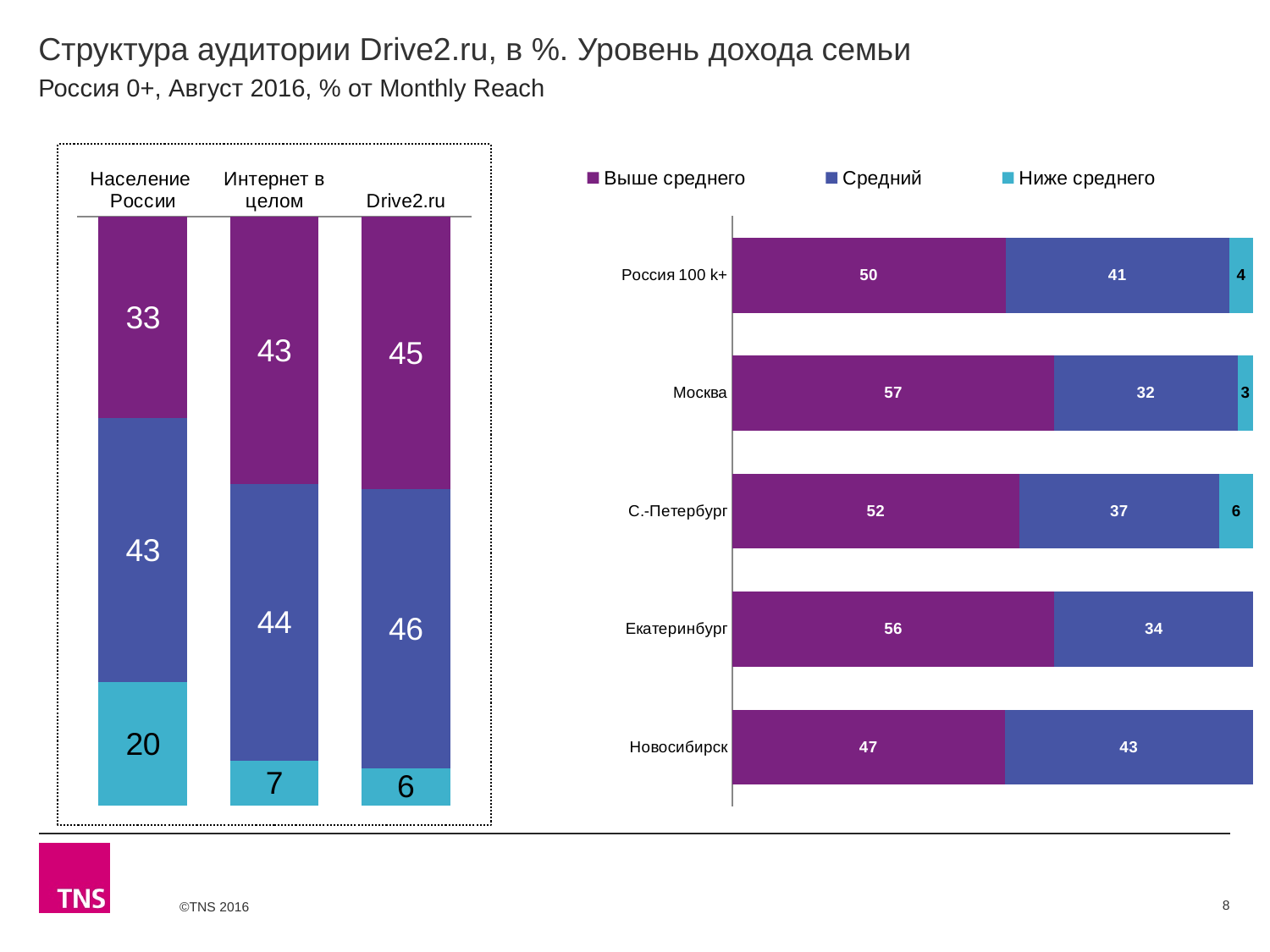
In the right chart, which category has the lowest 'Выше среднего' value? Новосибирск In the right chart, what is the 'Средний' value for 'Москва'? 32 In the left chart, what is the difference between the 'Ниже среднего' values for 'Население России' and 'Drive2.ru'? 14 In the left chart, what is the value of the 'Ниже среднего' segment for 'Население России'? 20 In the right chart, which is larger: the 'Средний' value for 'Россия 100 k+' or for 'Екатеринбург'? Россия 100 k+ In the left chart, what is the total of the stacked bar for 'Интернет в целом'? 94 In the right chart, which city has the highest 'Выше среднего' value? Москва What type of chart is the right chart? Stacked bar chart In the left chart, what is the value of the 'Выше среднего' segment for 'Drive2.ru'? 45 How many series does the legend of the right chart list? 3 In the right chart, what is the total of the stacked bar for 'Москва'? 92 How many categories are shown in the right chart? 5